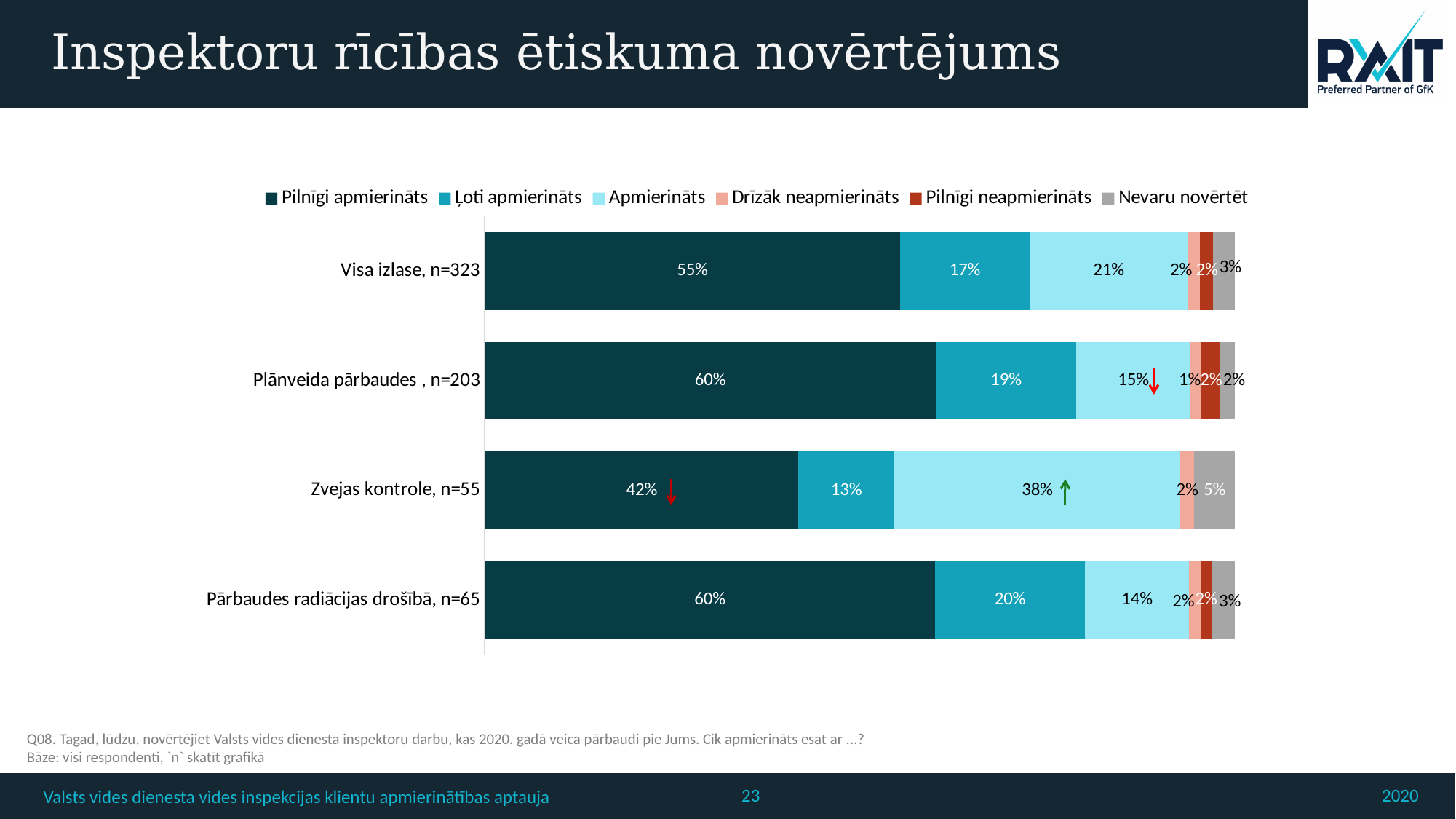
Which category has the highest value for 'Apmierināts'? Zvejas kontrole, n=55 Which is larger: 'Apmierināts' for 'Visa izlase, n=323' or for 'Pārbaudes radiācijas drošībā, n=65'? Visa izlase, n=323 What is the value of 'Nevaru novērtēt' for 'Zvejas kontrole, n=55'? 5% What is the difference in 'Pilnīgi apmierināts' between 'Visa izlase, n=323' and 'Zvejas kontrole, n=55'? 13 percentage points How many series does the legend list? 6 What is the value of 'Ļoti apmierināts' for 'Pārbaudes radiācijas drošībā, n=65'? 20% Which category has the lowest value for 'Pilnīgi apmierināts'? Zvejas kontrole, n=55 What is the value of 'Apmierināts' for 'Zvejas kontrole, n=55'? 38% What is the value of 'Pilnīgi apmierināts' for 'Visa izlase, n=323'? 55% How many categories (bars) are shown in the chart? 4 What kind of chart is shown on the slide? Stacked bar chart What is the title of the slide containing the chart? Inspektoru rīcības ētiskuma novērtējums